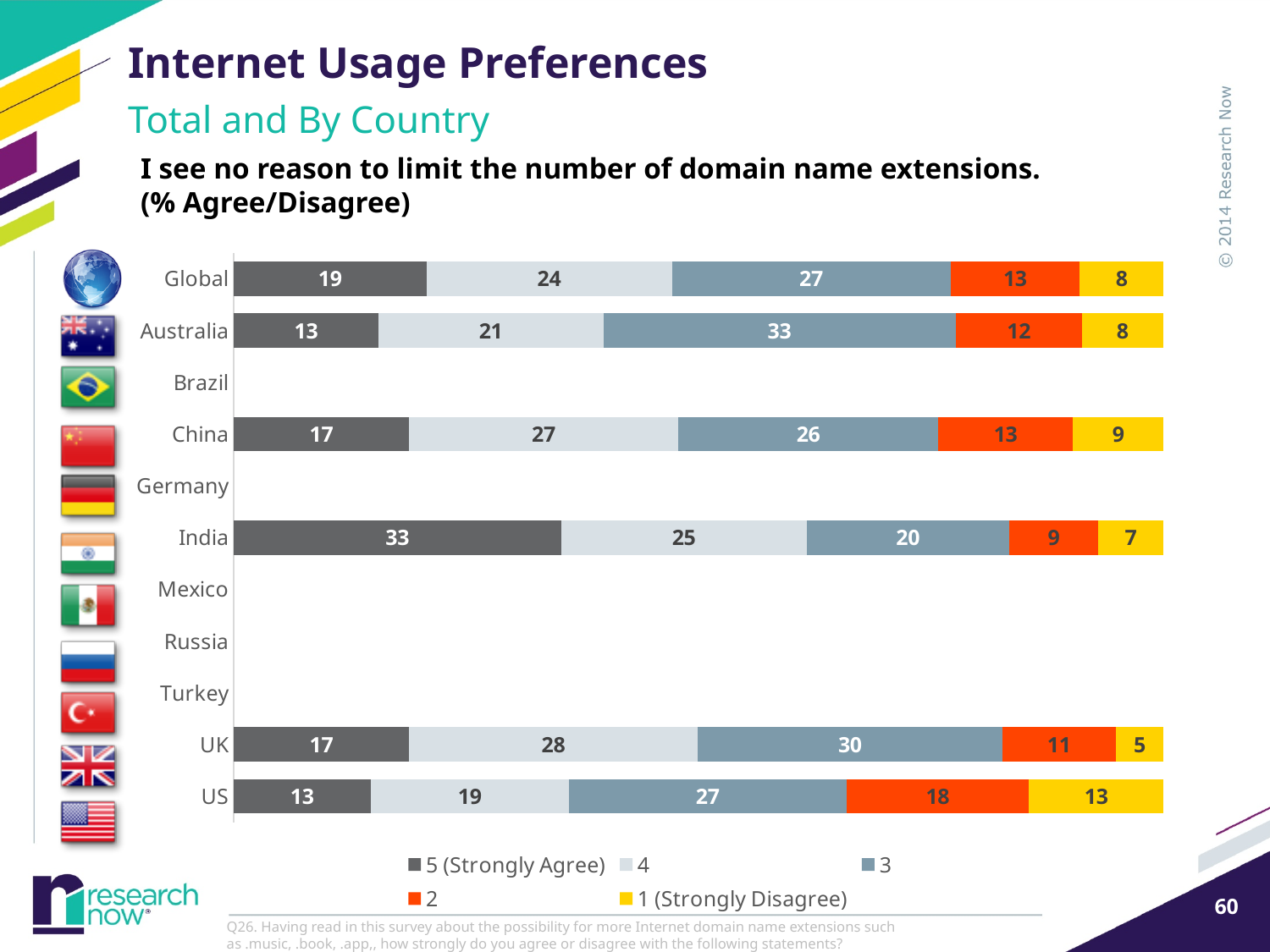
Which country has the highest value for 5 (Strongly Agree)? India Which is larger, the 4 value for the UK or the 4 value for China? UK What is the value for 3 for Australia? 33 What is the difference between the 2 value for the US and the 2 value for the UK? 7 Which legend entry is shown in yellow? 1 (Strongly Disagree) What type of chart is shown on the slide? Stacked bar chart How many countries (excluding Global) have data plotted in the chart? 5 What is the value for 5 (Strongly Agree) for India? 33 Which country has the lowest value for 1 (Strongly Disagree)? UK What is the value for 1 (Strongly Disagree) for the US? 13 How many series does the legend list? 5 What is the total of the stacked bar for Global? 91